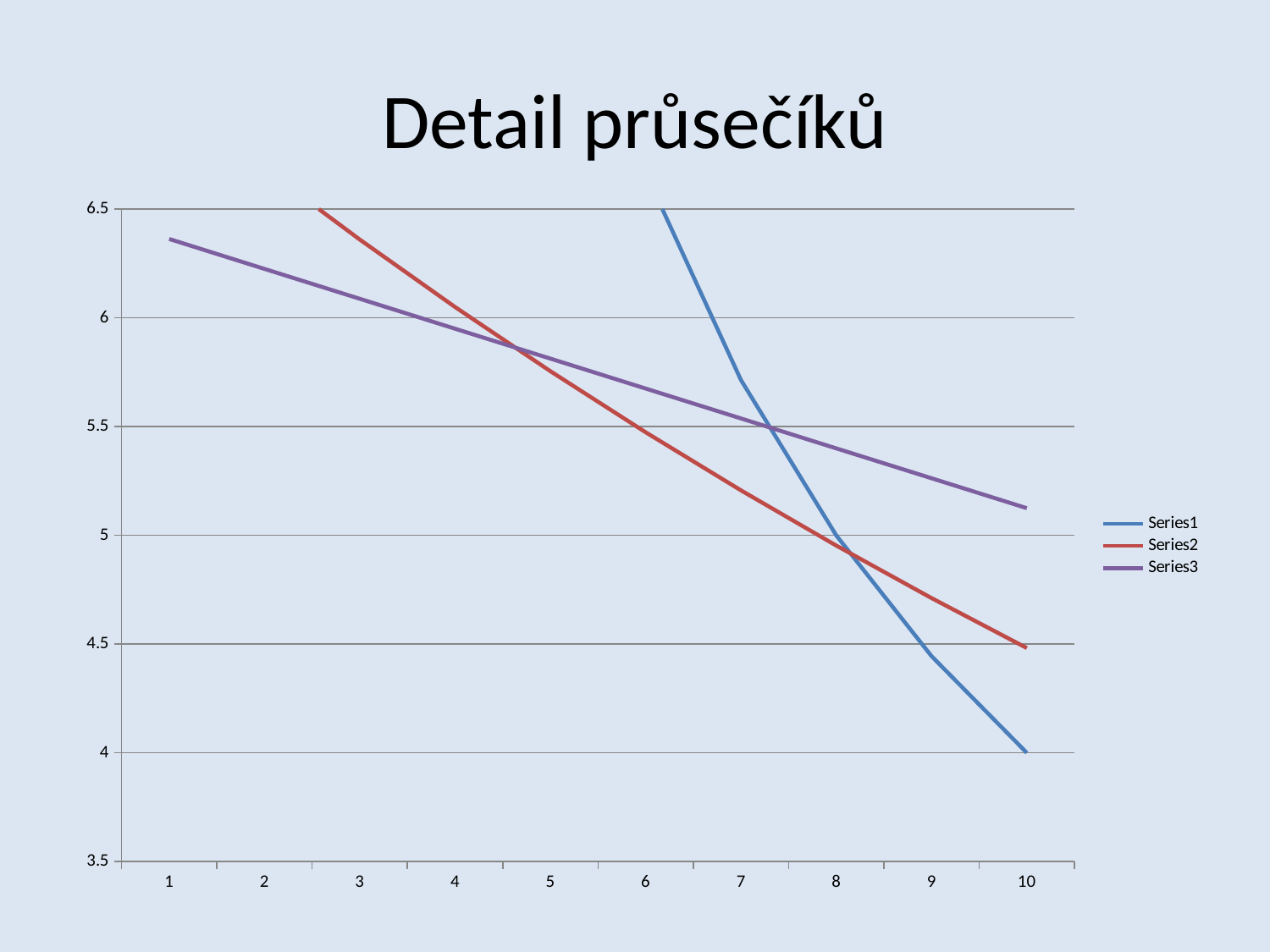
What is the title of the chart? Detail průsečíků How many series does the legend list? 3 Is the value of Series1 at x = 8 greater or less than 5.5? less Is the value of Series3 at x = 10 greater or less than 5? greater Which colour is used for Series2? red What is the value of Series1 at x = 10? 4 What kind of chart is shown on the slide? line chart Do the values of Series1 rise or fall as x increases? fall At x = 10, which is higher, Series3 or Series1? Series3 How many points are labelled on the x axis? 10 Is the value of Series3 at x = 1 greater or less than 6? greater Do the values of Series3 rise or fall as x increases? fall